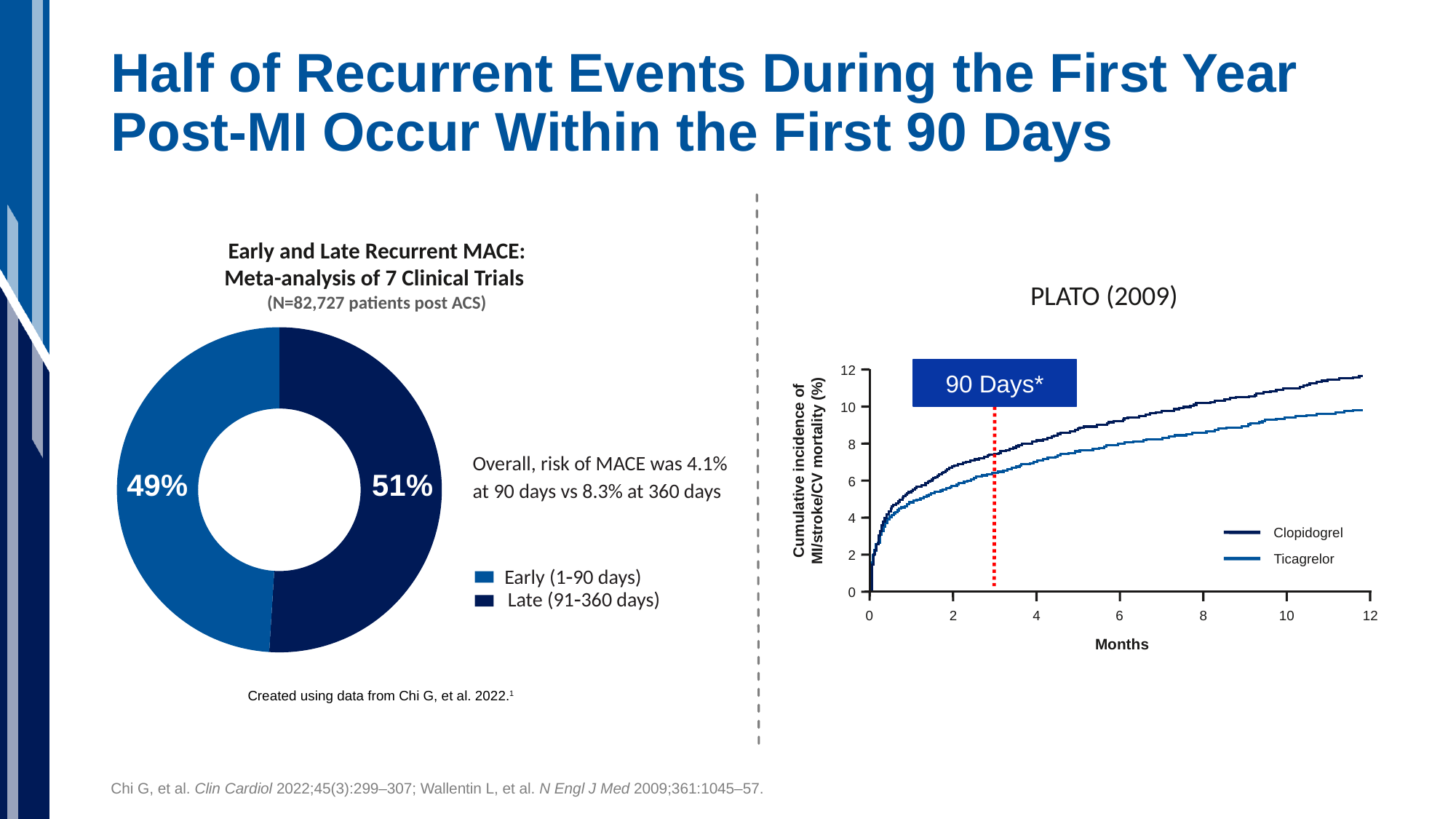
On the PLATO (2009) chart, do the cumulative incidence curves rise or fall as months increase? rise On the PLATO (2009) chart, is the cumulative incidence for Clopidogrel at 12 months greater or less than 10? greater On the PLATO (2009) chart, how many series does the legend list? 2 On the donut chart on the left, what is the difference in percentage points between the Late and Early shares? 2 percentage points On the donut chart on the left, what share of recurrent MACE occurred in the Early (1-90 days) period? 49% On the PLATO (2009) chart, what is the label of the x axis? Months On the donut chart on the left, what share of recurrent MACE occurred in the Late (91-360 days) period? 51% On the PLATO (2009) chart, which series has the higher cumulative incidence at 12 months, Clopidogrel or Ticagrelor? Clopidogrel What type of chart is the chart on the left of the slide? Donut (pie) chart On the donut chart on the left, which category has the larger share, Early (1-90 days) or Late (91-360 days)? Late (91-360 days) On the donut chart on the left, how many categories are shown? 2